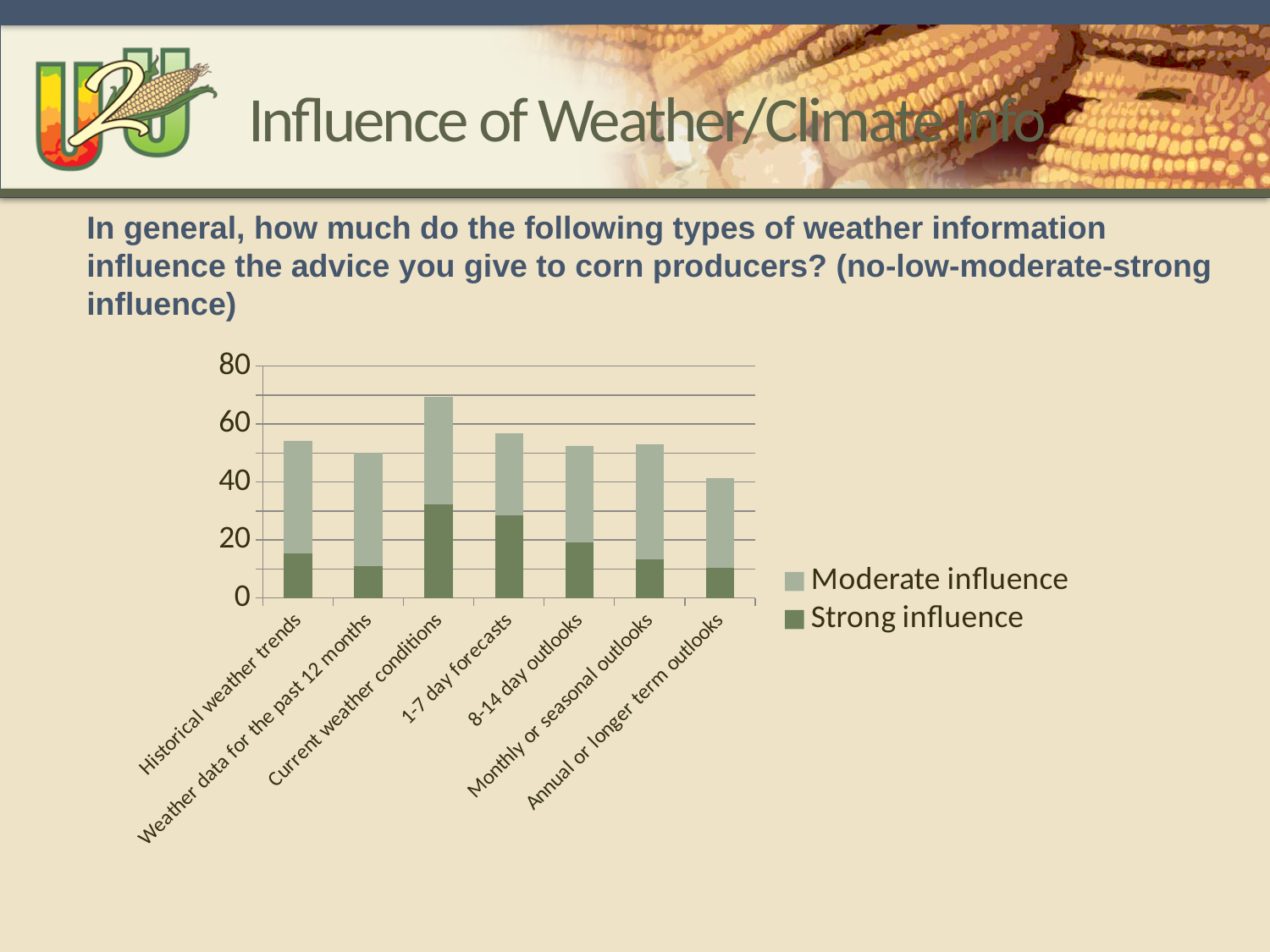
Is the Strong influence value for Current weather conditions greater or less than 20? greater Is the total stacked value for Current weather conditions greater or less than 60? greater How many categories are shown on the x axis of the chart? 7 Which category has the largest Strong influence segment? Current weather conditions How many series does the chart's legend list? 2 Which has a larger Strong influence segment, 1-7 day forecasts or Monthly or seasonal outlooks? 1-7 day forecasts Which category has the shortest stacked bar overall? Annual or longer term outlooks What kind of chart is shown on the slide? Stacked bar chart Which category has the tallest stacked bar overall? Current weather conditions Is the total stacked value for Annual or longer term outlooks greater or less than 60? less Which legend entry is shown in the darker green colour? Strong influence